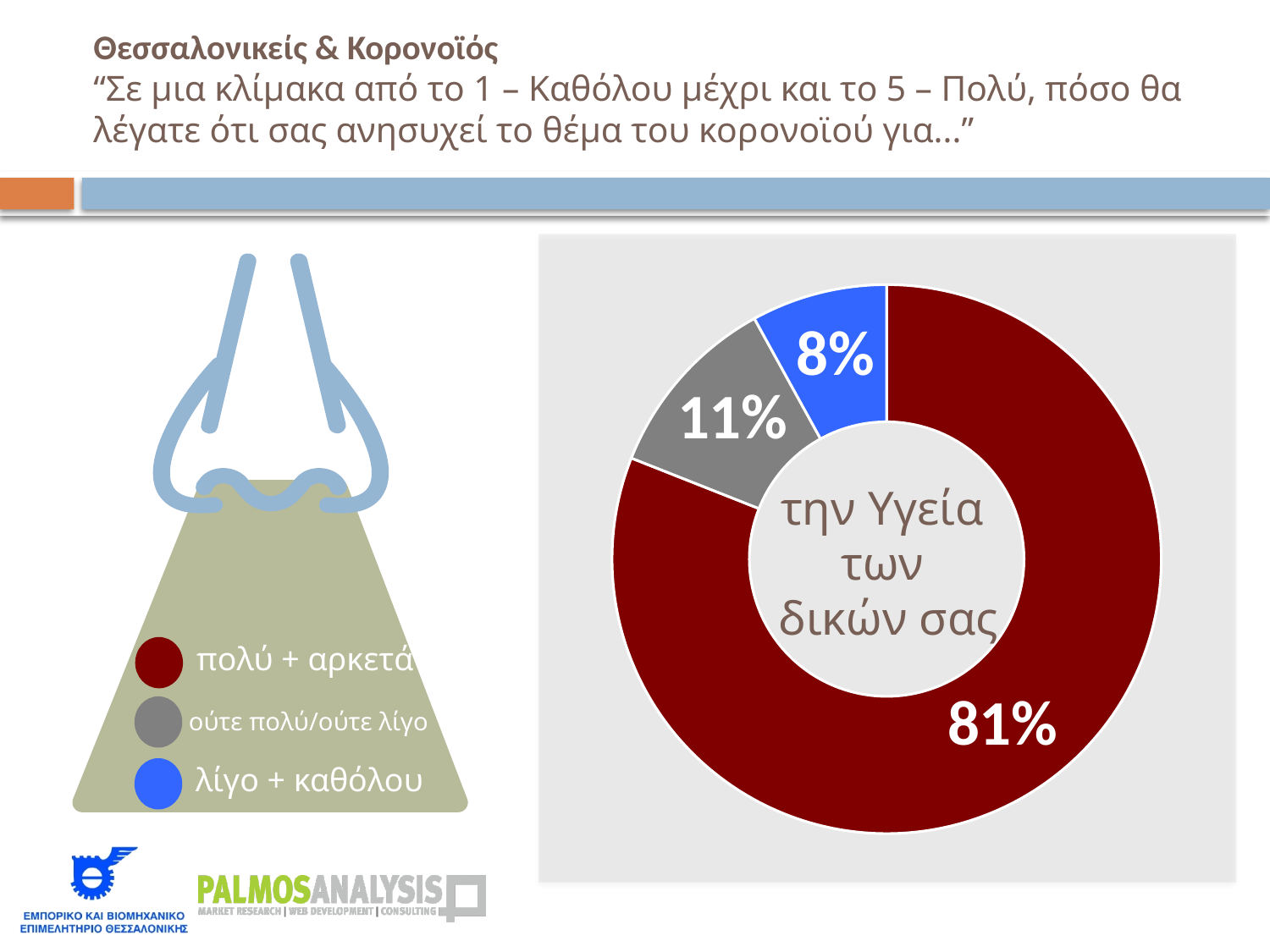
What percentage of respondents answered "πολύ + αρκετά" regarding concern for the health of their loved ones? 81% What percentage of respondents answered "ούτε πολύ/ούτε λίγο"? 11% Which response category has the largest share of the donut chart? πολύ + αρκετά What is the difference in percentage points between "πολύ + αρκετά" and "ούτε πολύ/ούτε λίγο"? 70 percentage points Which is larger: the share for "ούτε πολύ/ούτε λίγο" or the share for "λίγο + καθόλου"? ούτε πολύ/ούτε λίγο Which response category has the smallest share of the donut chart? λίγο + καθόλου What topic is written in the centre of the donut chart? την Υγεία των δικών σας What is the difference in percentage points between "ούτε πολύ/ούτε λίγο" and "λίγο + καθόλου"? 3 percentage points What percentage of respondents answered "λίγο + καθόλου"? 8% What kind of chart is shown on the slide? Donut (pie) chart How many slices does the donut chart have? 3 Which colour represents the "λίγο + καθόλου" category in the chart? Blue